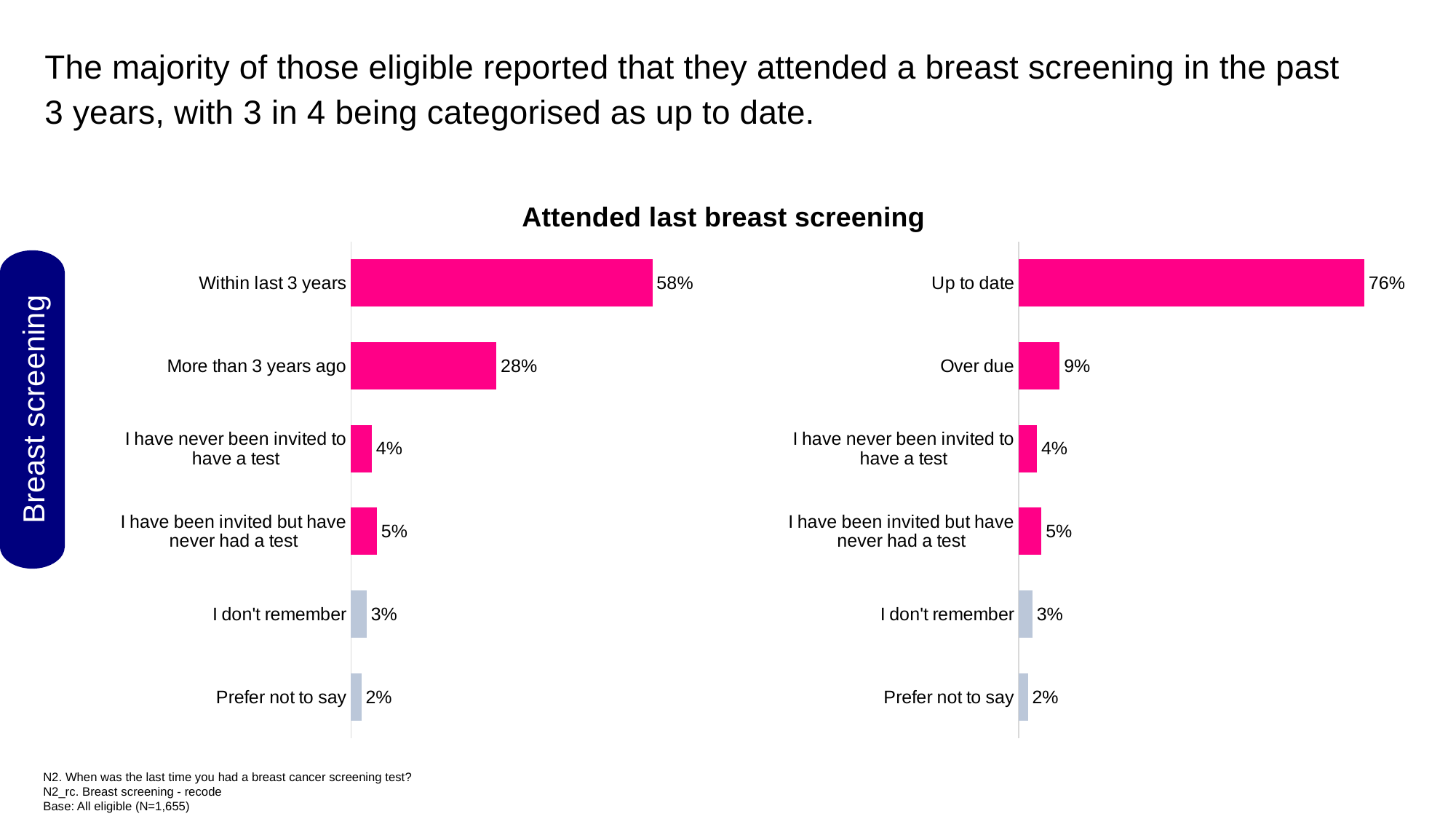
In the left chart, what is the value for 'Within last 3 years'? 58% What is the title shown above the charts? Attended last breast screening In the left chart, which category has the highest value? Within last 3 years In the right chart, what is the difference between 'Up to date' and 'Over due'? 67 percentage points In the right chart, what is the value for 'Over due'? 9% In the right chart, which category has the lowest value? Prefer not to say How many categories does the left chart show? 6 What kind of chart is used on this slide? Bar chart In the right chart, what is the value for 'Up to date'? 76% In the left chart, which is larger: 'I have never been invited to have a test' or 'I have been invited but have never had a test'? I have been invited but have never had a test In the left chart, what is the difference between 'Within last 3 years' and 'More than 3 years ago'? 30 percentage points In the left chart, what is the value for 'More than 3 years ago'? 28%